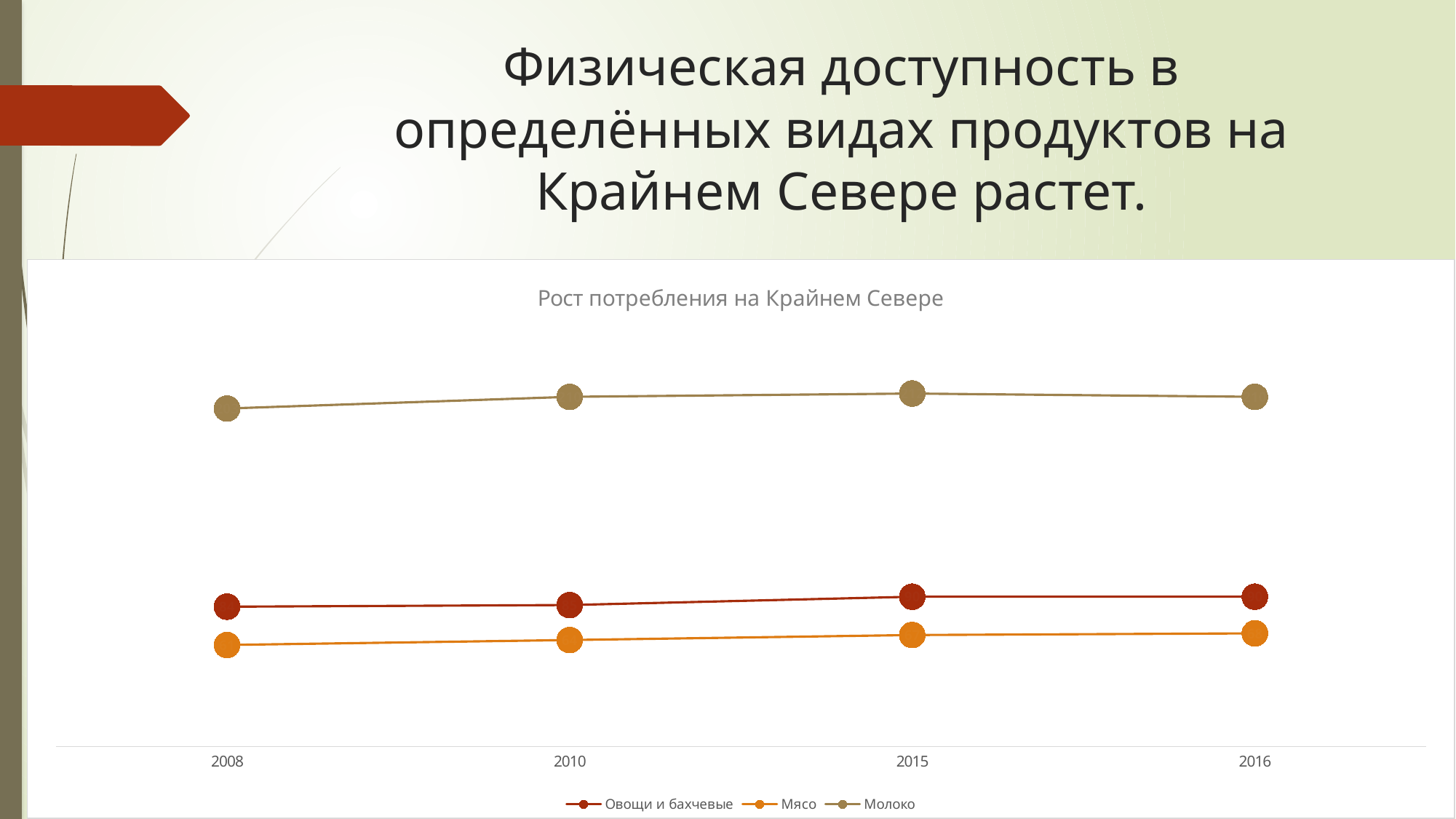
In which year is the Мясо value lowest? 2008 In which year is the Молоко value lowest? 2008 In 2016, which is higher: Овощи и бахчевые or Мясо? Овощи и бахчевые Which series are listed in the legend? Овощи и бахчевые, Мясо, Молоко In 2008, which is higher: Молоко or Мясо? Молоко What is the title of the chart? Рост потребления на Крайнем Севере How many years are shown on the x axis? 4 Which series has the lowest values across all years? Мясо How many series does the legend list? 3 Which series has the highest values across all years? Молоко Does the Мясо line rise or fall from 2008 to 2016? rise What kind of chart is shown on the slide? line chart